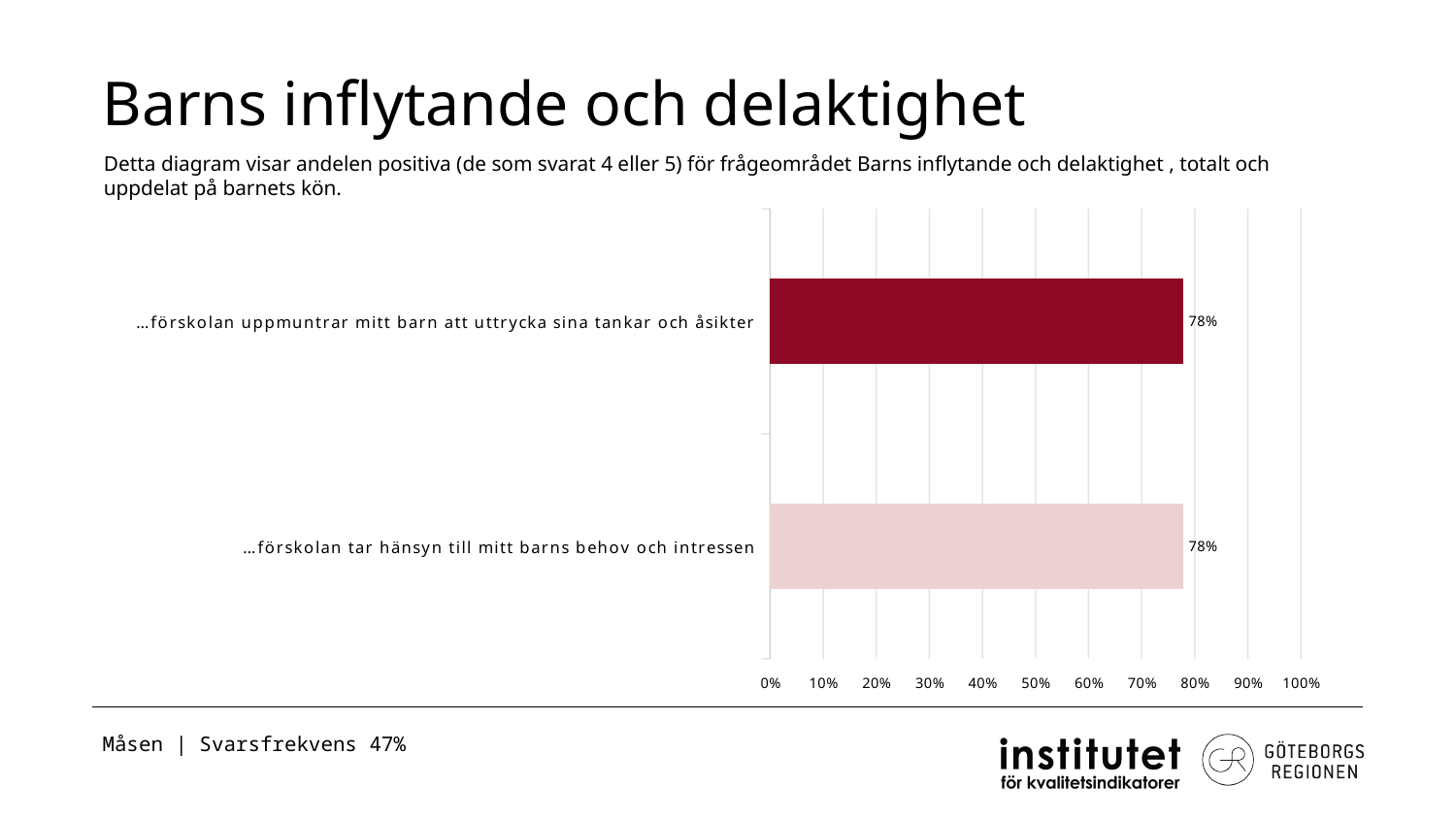
How many categories are shown in the chart? 2 What kind of chart is shown on the slide? Bar chart Is the value for "…förskolan uppmuntrar mitt barn att uttrycka sina tankar och åsikter" greater or less than 70%? greater What is the difference between the values for "…förskolan uppmuntrar mitt barn att uttrycka sina tankar och åsikter" and "…förskolan tar hänsyn till mitt barns behov och intressen"? 0% What is the value for "…förskolan tar hänsyn till mitt barns behov och intressen"? 78% What is the highest value shown on the x axis of the chart? 100% Is the value for "…förskolan tar hänsyn till mitt barns behov och intressen" greater or less than 80%? less What is the value for "…förskolan uppmuntrar mitt barn att uttrycka sina tankar och åsikter"? 78% What is the title of the slide containing the chart? Barns inflytande och delaktighet Which has the larger value: "…förskolan uppmuntrar mitt barn att uttrycka sina tankar och åsikter" or "…förskolan tar hänsyn till mitt barns behov och intressen"? They are equal (both 78%)